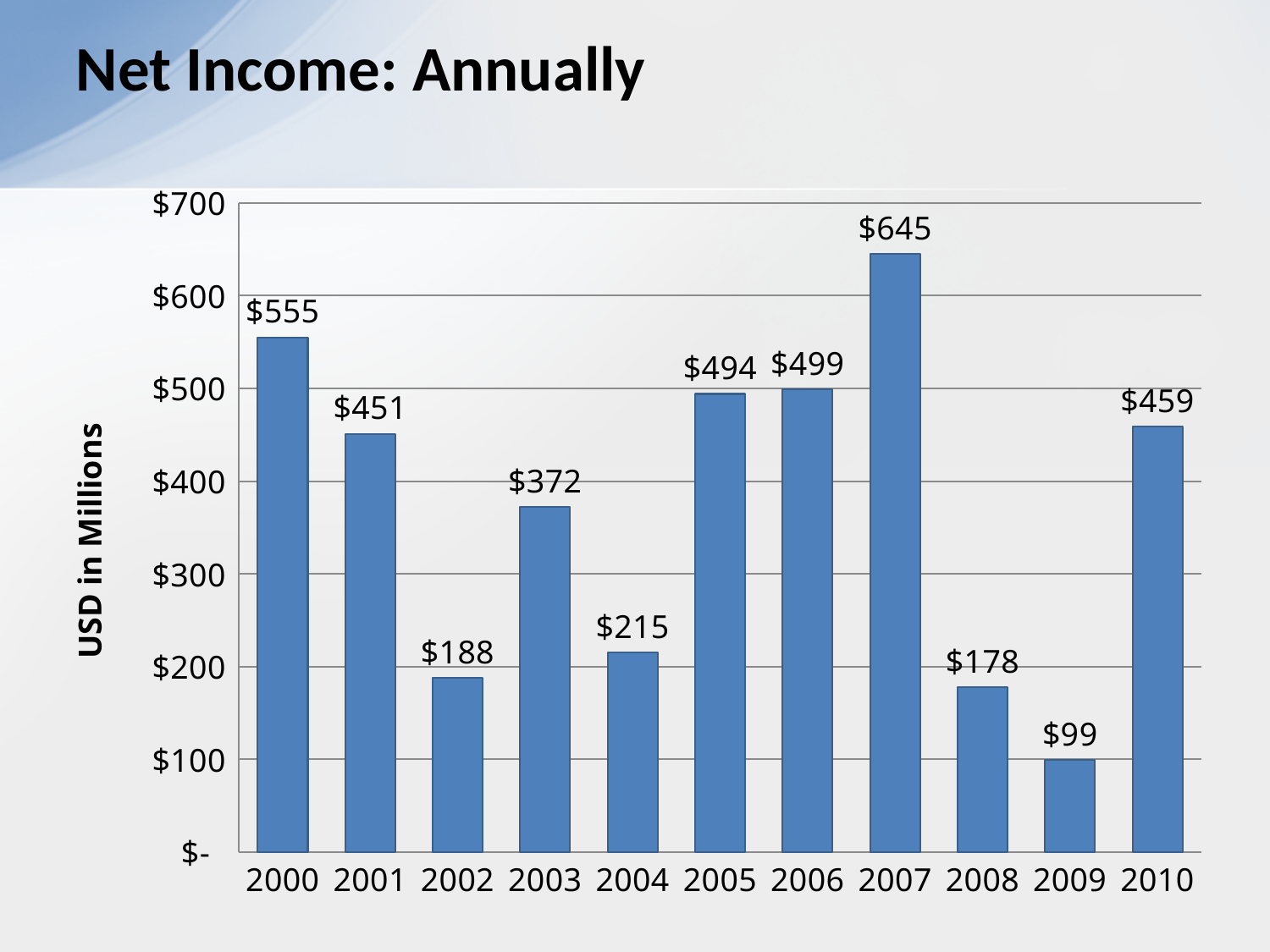
What is the net income for 2002? $188 Which year has the lowest net income? 2009 Which year has the highest net income? 2007 How many years are shown on the chart? 11 Is the net income for 2008 greater or less than $200? less What is the net income for 2007? $645 What is the net income for 2010? $459 Which year has a higher net income, 2003 or 2004? 2003 What is the label on the vertical axis of the chart? USD in Millions What kind of chart is shown on the slide? Bar chart What is the difference between the net income in 2007 and in 2009? $546 What is the difference between the net income in 2000 and in 2001? $104